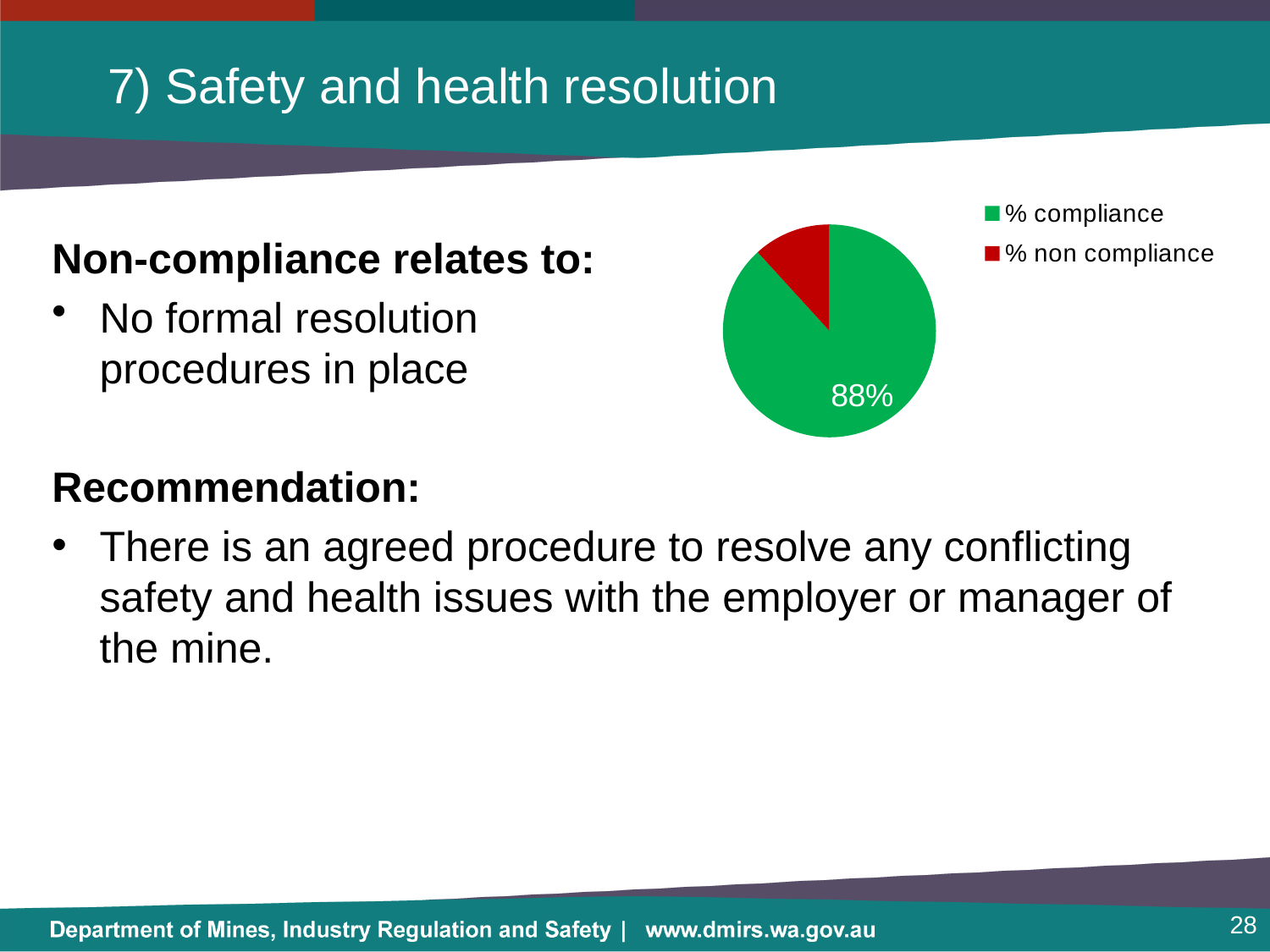
How many slices does the pie chart have? 2 What colour represents % non compliance in the pie chart? red Which slice of the pie chart is the largest? % compliance What kind of chart is shown on the slide? pie chart Which slice of the pie chart is the smallest? % non compliance What value is shown for % compliance in the pie chart? 88% What colour represents % compliance in the pie chart? green What share of the pie does the % compliance slice represent? 88% Which is larger in the pie chart, % compliance or % non compliance? % compliance How many entries does the legend of the pie chart list? 2